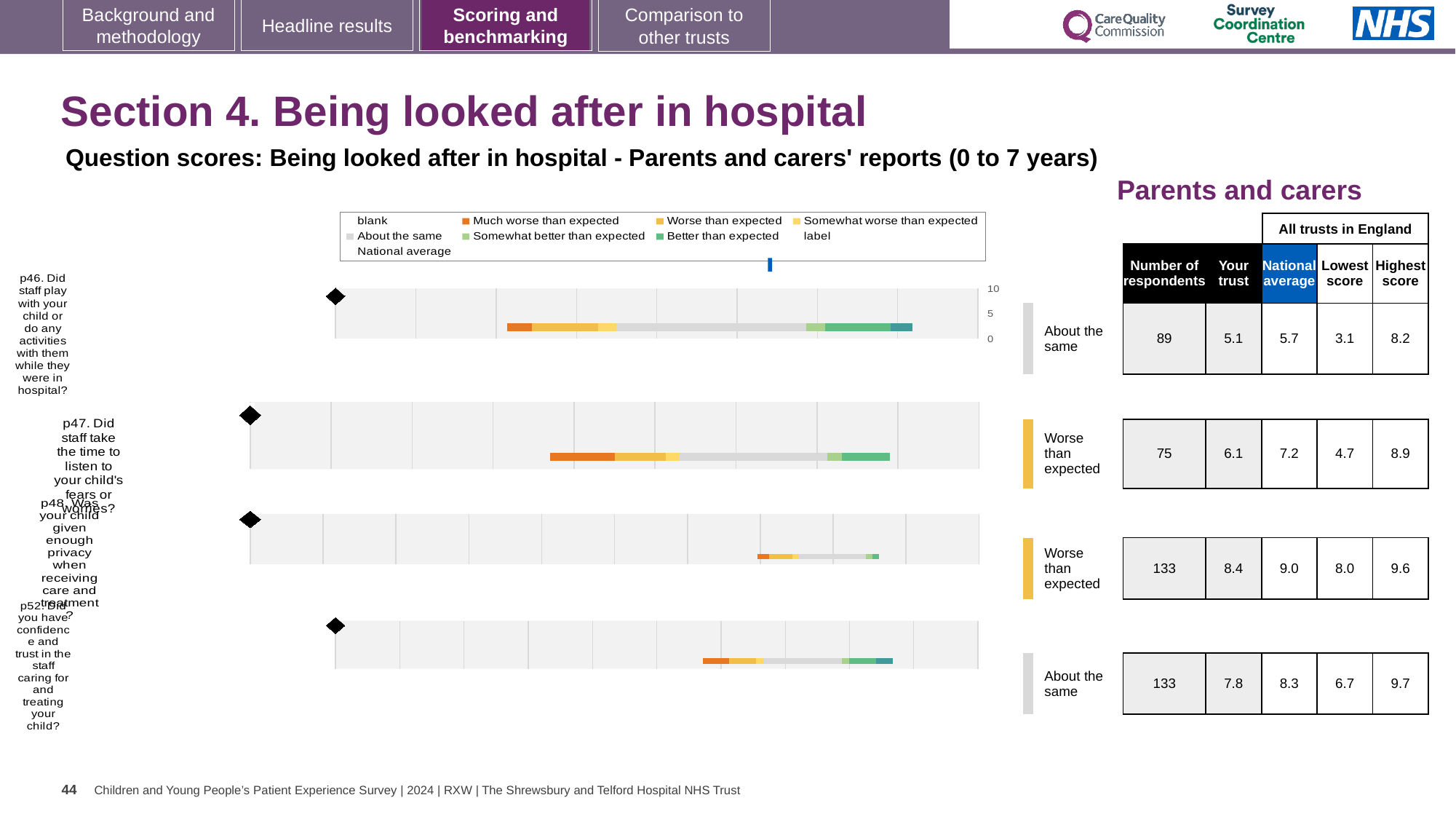
What colour does the legend use for 'Much worse than expected'? orange In the table beside the charts, what is the 'Your trust' score for p47 (Did staff take the time to listen to your child's fears or worries?)? 6.1 In the table beside the charts, how many respondents are listed for p46 (Did staff play with your child or do any activities with them while they were in hospital?)? 89 Which question has the lowest 'Your trust' score in the table beside the charts? p46 Which has the higher 'Your trust' score, p48 or p52? p48 How many separate question charts are shown on the slide? 4 In the table beside the charts, what is the national average for p48 (Was your child given enough privacy when receiving care and treatment?)? 9.0 What benchmark label is shown next to the p47 chart? Worse than expected What is the highest axis tick value shown on the p46 chart? 10 What kind of chart is used for each question in the 'Being looked after in hospital' section? bar chart What is the difference between the national average and the 'Your trust' score for p47? 1.1 In the table beside the charts, what is the highest score among all trusts in England for p52 (Did you have confidence and trust in the staff caring for and treating your child?)? 9.7